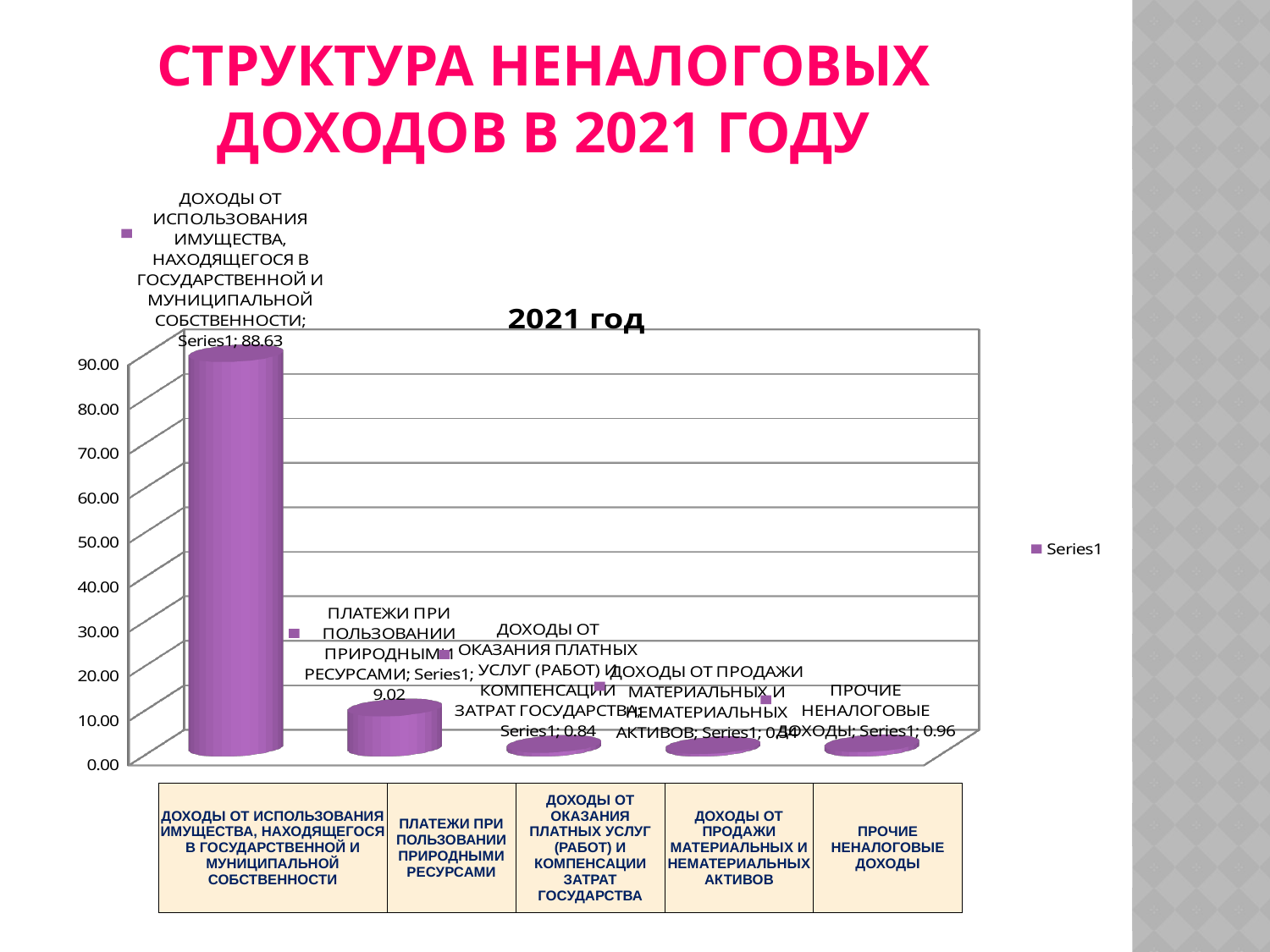
Is the value for ДОХОДЫ ОТ ИСПОЛЬЗОВАНИЯ ИМУЩЕСТВА greater or less than 80.00? greater What is the difference between the values for ДОХОДЫ ОТ ИСПОЛЬЗОВАНИЯ ИМУЩЕСТВА and ПЛАТЕЖИ ПРИ ПОЛЬЗОВАНИИ ПРИРОДНЫМИ РЕСУРСАМИ? 79.61 Which category has the highest value? ДОХОДЫ ОТ ИСПОЛЬЗОВАНИЯ ИМУЩЕСТВА, НАХОДЯЩЕГОСЯ В ГОСУДАРСТВЕННОЙ И МУНИЦИПАЛЬНОЙ СОБСТВЕННОСТИ How many series does the legend list? 1 What kind of chart is shown on the slide? Bar chart What is the value for ДОХОДЫ ОТ ОКАЗАНИЯ ПЛАТНЫХ УСЛУГ (РАБОТ) И КОМПЕНСАЦИИ ЗАТРАТ ГОСУДАРСТВА? 0.84 How many categories are shown in the chart? 5 What is the value for ПЛАТЕЖИ ПРИ ПОЛЬЗОВАНИИ ПРИРОДНЫМИ РЕСУРСАМИ? 9.02 What is the value for ДОХОДЫ ОТ ИСПОЛЬЗОВАНИЯ ИМУЩЕСТВА, НАХОДЯЩЕГОСЯ В ГОСУДАРСТВЕННОЙ И МУНИЦИПАЛЬНОЙ СОБСТВЕННОСТИ? 88.63 What is the value for ПРОЧИЕ НЕНАЛОГОВЫЕ ДОХОДЫ? 0.96 Is the value for ПЛАТЕЖИ ПРИ ПОЛЬЗОВАНИИ ПРИРОДНЫМИ РЕСУРСАМИ greater or less than 20.00? less Which is larger: the value for ПРОЧИЕ НЕНАЛОГОВЫЕ ДОХОДЫ or the value for ДОХОДЫ ОТ ОКАЗАНИЯ ПЛАТНЫХ УСЛУГ (РАБОТ) И КОМПЕНСАЦИИ ЗАТРАТ ГОСУДАРСТВА? ПРОЧИЕ НЕНАЛОГОВЫЕ ДОХОДЫ